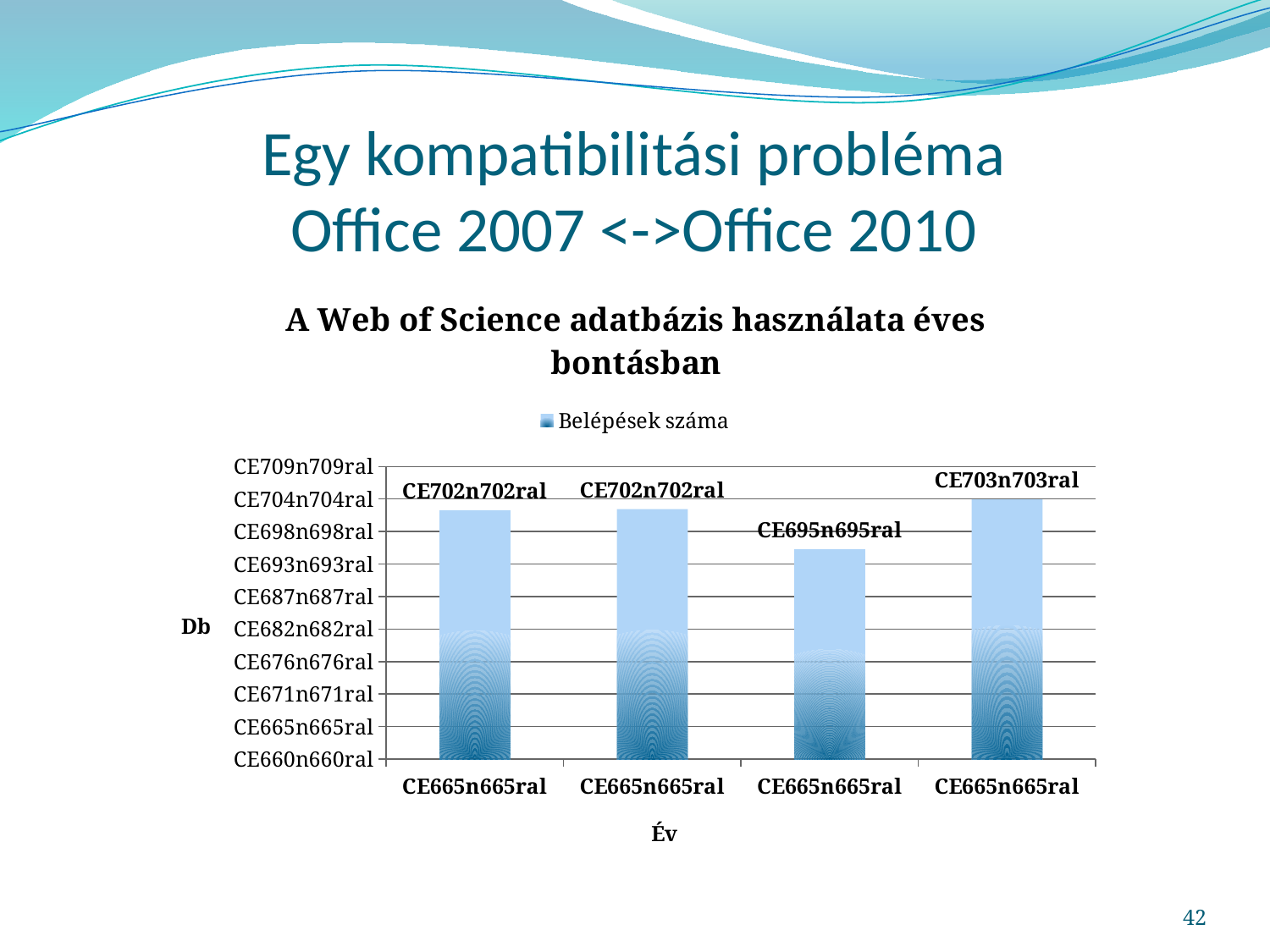
Which bar, counting from the left, is the tallest? The fourth bar What is the title of the vertical axis? Db What is the name of the series shown in the legend? Belépések száma How many bars are plotted in the chart? 4 What data label is printed above the fourth bar from the left? CE703n703ral Which bar, counting from the left, is the shortest? The third bar What is the title of the chart? A Web of Science adatbázis használata éves bontásban What data label is printed above the third bar from the left? CE695n695ral How many series does the chart legend list? 1 Is the third bar from the left taller or shorter than the second bar? Shorter What kind of chart is shown on the slide? Bar chart